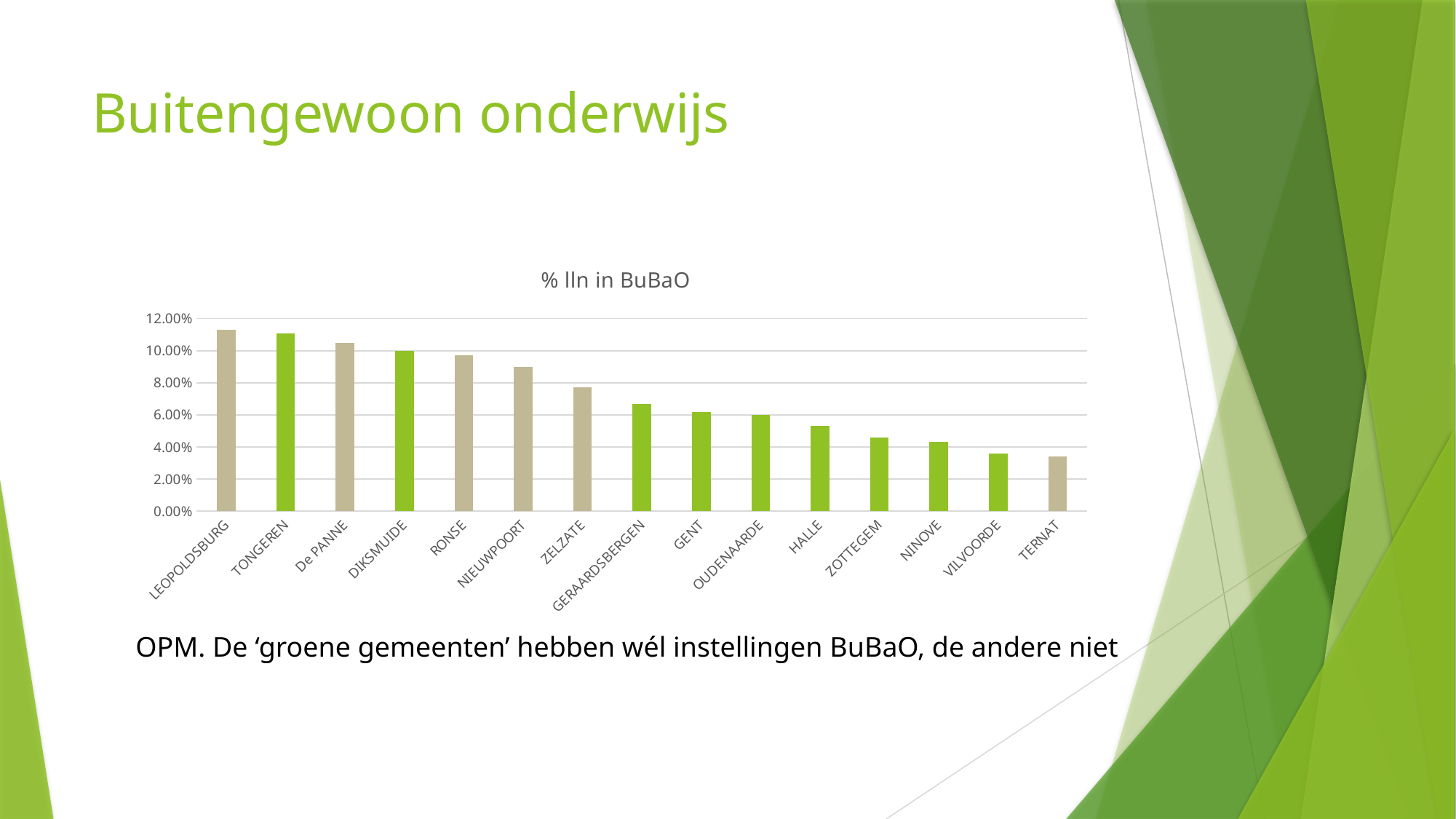
Is the value for HALLE greater or less than 6.00%? less How many bars in the chart are coloured green? 9 Is the value for TERNAT greater or less than 4.00%? less Which has a larger value, RONSE or GENT? RONSE Which municipality has the highest value in the chart? LEOPOLDSBURG Is the value for LEOPOLDSBURG greater or less than 10.00%? greater What is the title of the chart? % lln in BuBaO Do the values rise or fall from left to right along the x axis? fall Which has a larger value, HALLE or ZELZATE? ZELZATE What kind of chart is shown on the slide? bar chart How many municipalities are shown on the x axis of the chart? 15